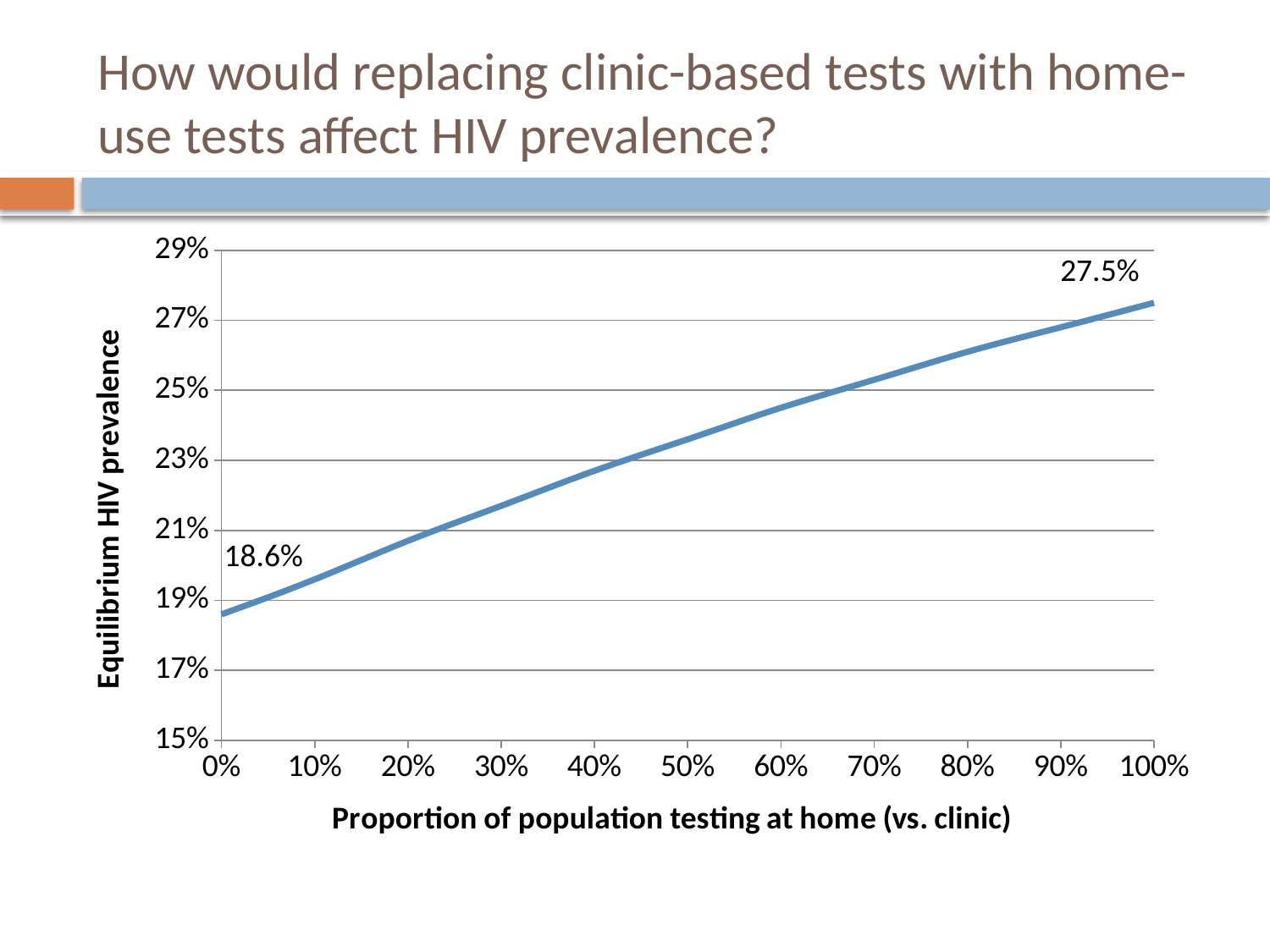
Which has the higher equilibrium HIV prevalence: 0% home testing or 100% home testing? 100% home testing What is the equilibrium HIV prevalence when 100% of the population tests at home? 27.5% Is the equilibrium HIV prevalence at 50% home testing greater or less than 25%? less What kind of chart is shown on the slide? Line chart Is the equilibrium HIV prevalence at 80% home testing greater or less than 25%? greater Is the equilibrium HIV prevalence at 30% home testing greater or less than 23%? less What is the equilibrium HIV prevalence when 0% of the population tests at home? 18.6% At what proportion of home testing is equilibrium HIV prevalence highest? 100% Does equilibrium HIV prevalence rise or fall as the proportion of the population testing at home increases? Rises At what proportion of home testing is equilibrium HIV prevalence lowest? 0% What is the title of the x axis of the chart? Proportion of population testing at home (vs. clinic) By how many percentage points does equilibrium HIV prevalence differ between 0% and 100% home testing? 8.9 percentage points